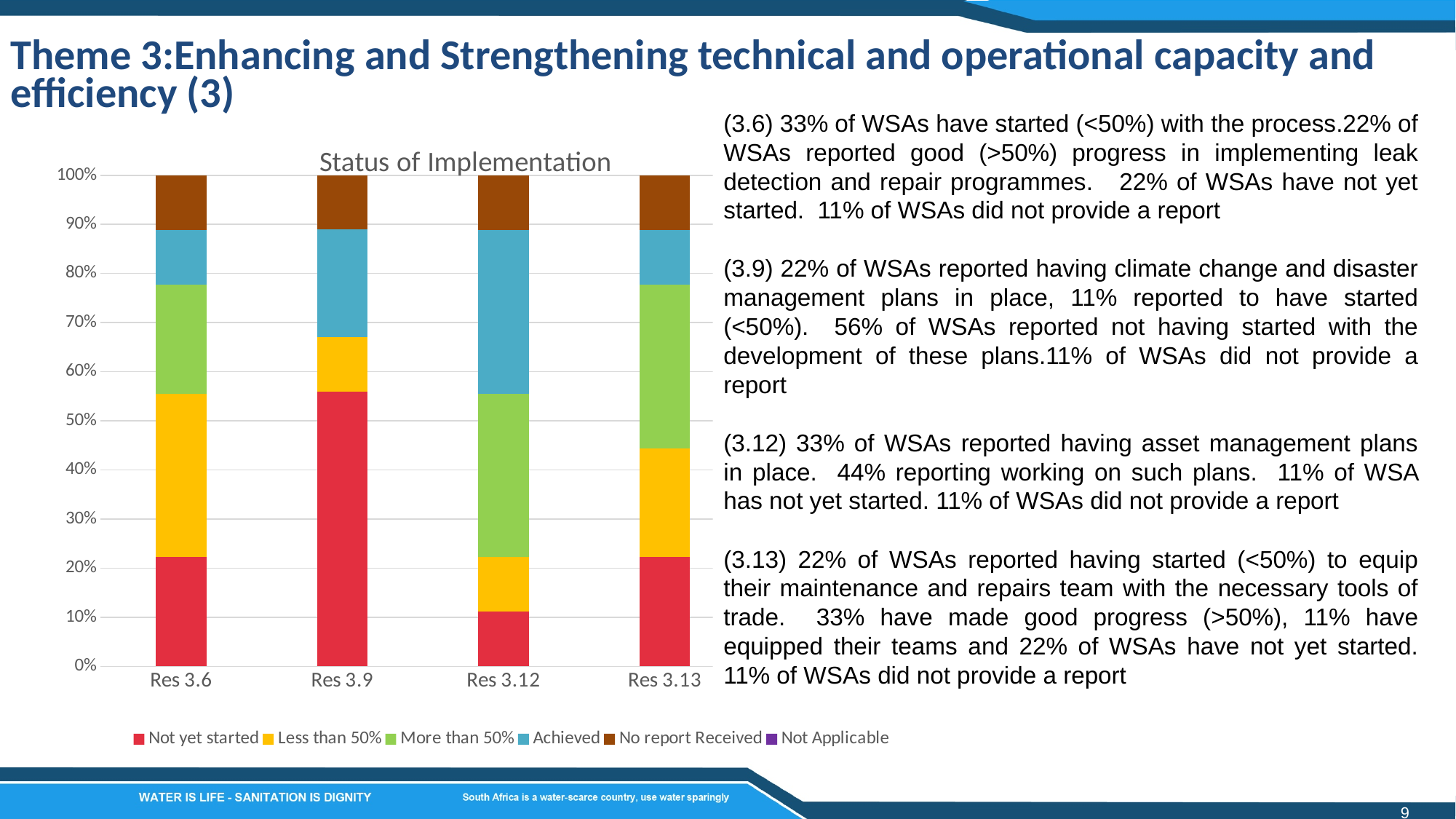
Which is larger, the 'Not yet started' segment for Res 3.9 or for Res 3.12? Res 3.9 Which category has the largest 'Not yet started' segment? Res 3.9 How many series does the chart legend list? 6 What kind of chart is shown on the slide? Stacked bar chart Which category has the smallest 'Not yet started' segment? Res 3.12 Is the 'Not yet started' segment for Res 3.9 greater or less than 50%? greater How many categories are shown on the x axis of the chart? 4 Which legend entry is shown in purple? Not Applicable What is the title of the chart? Status of Implementation Which category has the largest 'Achieved' segment? Res 3.12 What is the total height of the Res 3.6 stacked bar? 100% Is the 'Not yet started' segment for Res 3.12 greater or less than 20%? less